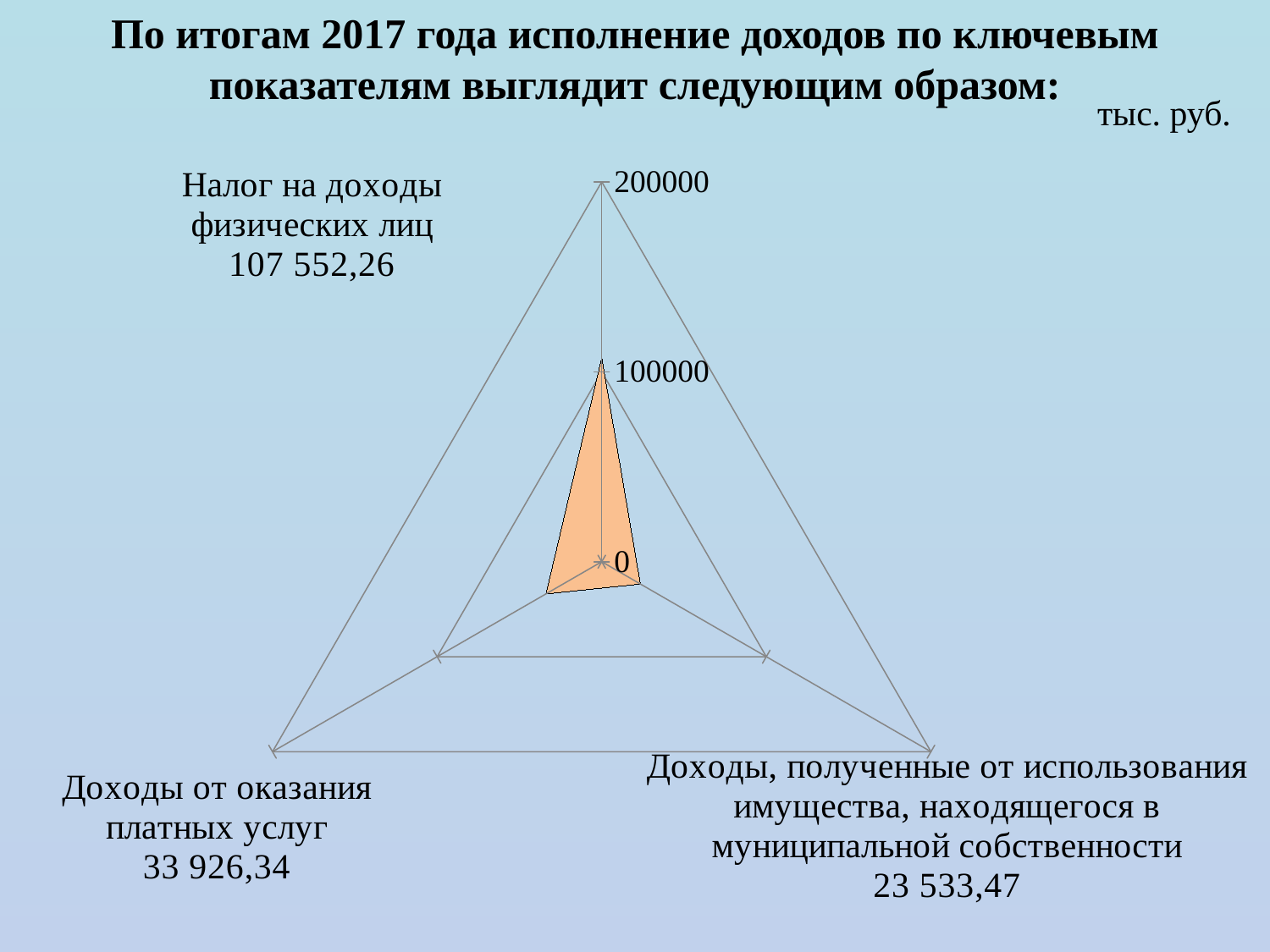
Which category has the highest value? Налог на доходы физических лиц What kind of chart is shown on the slide? radar chart What is the difference between the value for Доходы от оказания платных услуг and the value for Доходы, полученные от использования имущества, находящегося в муниципальной собственности? 10 392,87 What is the value for Налог на доходы физических лиц? 107 552,26 What is the value for Доходы, полученные от использования имущества, находящегося в муниципальной собственности? 23 533,47 What is the value for Доходы от оказания платных услуг? 33 926,34 Which category has the lowest value? Доходы, полученные от использования имущества, находящегося в муниципальной собственности In what units are the values on the chart given? тыс. руб. Which is larger: the value for Доходы от оказания платных услуг or the value for Доходы, полученные от использования имущества, находящегося в муниципальной собственности? Доходы от оказания платных услуг How many categories does the chart show? 3 What is the difference between the value for Налог на доходы физических лиц and the value for Доходы от оказания платных услуг? 73 625,92 Is the value for Налог на доходы физических лиц greater or less than 100000? greater